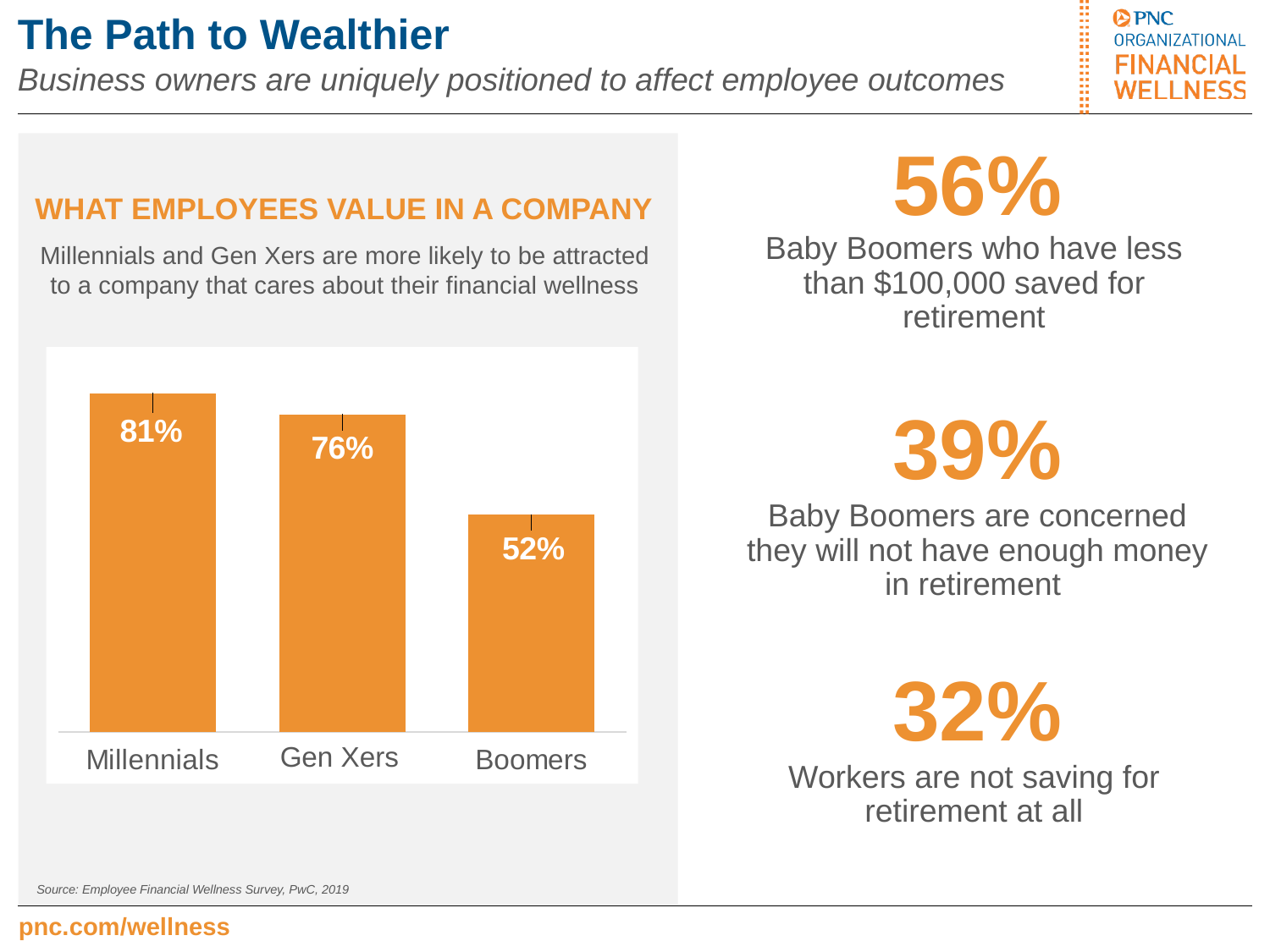
What is the value for Boomers in the chart? 52% What kind of chart is shown on the slide? Bar chart What is the difference between the values for Millennials and Gen Xers? 5% Which is larger, the value for Gen Xers or the value for Boomers? Gen Xers How many categories are shown in the chart? 3 What is the value for Gen Xers in the chart? 76% Which category has the highest value in the chart? Millennials Which category has the lowest value in the chart? Boomers What is the title of the chart section on the slide? WHAT EMPLOYEES VALUE IN A COMPANY What is the value for Millennials in the chart? 81% Do the values rise or fall from left to right across the chart? Fall What is the difference between the values for Millennials and Boomers? 29%